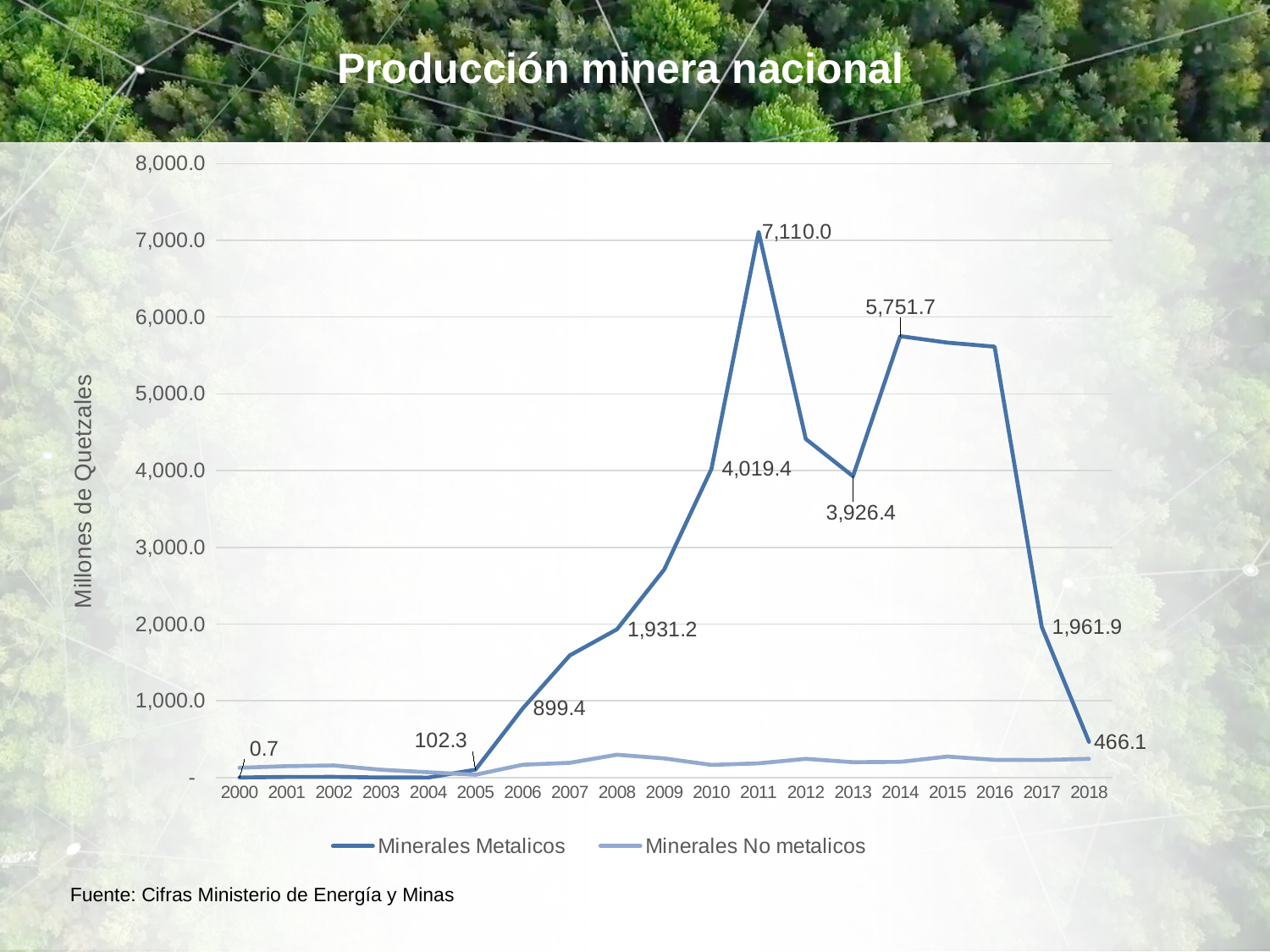
What is the value for Minerales Metalicos in 2005? 102.3 What type of chart is shown on the slide? line chart What is the value for Minerales Metalicos in 2018? 466.1 What is the difference between the Minerales Metalicos values in 2017 and 2018? 1,495.8 What is the label of the vertical axis? Millones de Quetzales How many series does the legend list? 2 Which is larger for Minerales Metalicos: the value in 2010 or the value in 2013? 2010 What is the difference between the Minerales Metalicos values in 2011 and 2013? 3,183.6 In which year does Minerales Metalicos reach its highest value? 2011 What is the value for Minerales Metalicos in 2011? 7,110.0 What is the value for Minerales Metalicos in 2014? 5,751.7 Is the value for Minerales Metalicos in 2016 greater or less than 5,000.0? greater